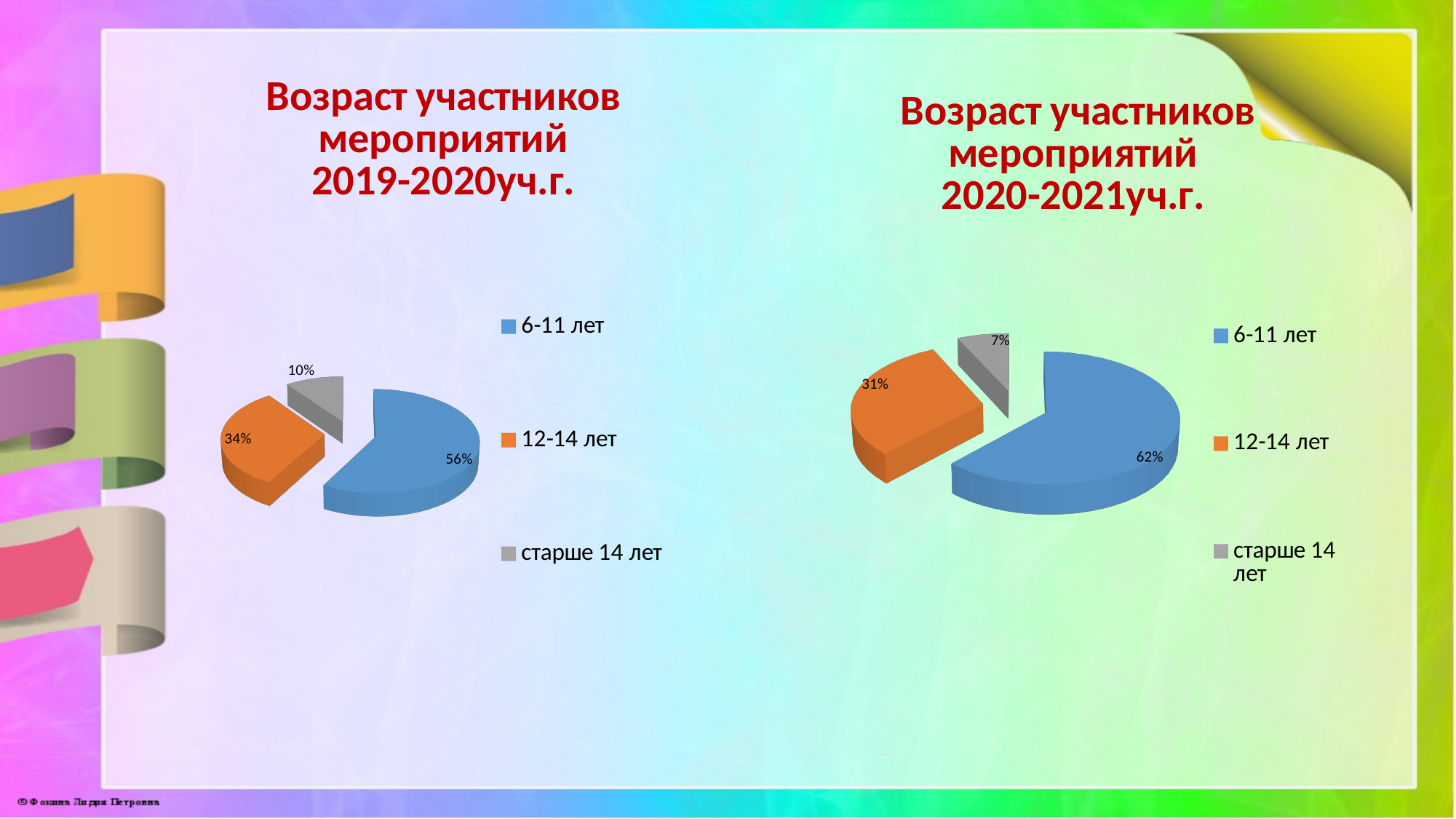
How many categories does the legend of the chart titled 'Возраст участников мероприятий 2019-2020уч.г.' list? 3 In the chart titled 'Возраст участников мероприятий 2019-2020уч.г.', what is the difference between the shares for 6-11 лет and 12-14 лет? 22% What type of chart is the one titled 'Возраст участников мероприятий 2020-2021уч.г.'? Pie chart In the chart titled 'Возраст участников мероприятий 2020-2021уч.г.', which is larger: the share for 12-14 лет or the share for старше 14 лет? 12-14 лет In the chart titled 'Возраст участников мероприятий 2020-2021уч.г.', what share is shown for старше 14 лет? 7% In the chart titled 'Возраст участников мероприятий 2019-2020уч.г.', what share is shown for старше 14 лет? 10% In the chart titled 'Возраст участников мероприятий 2019-2020уч.г.', what share is shown for 12-14 лет? 34% In the chart titled 'Возраст участников мероприятий 2020-2021уч.г.', which age group has the smallest share? старше 14 лет In the chart titled 'Возраст участников мероприятий 2020-2021уч.г.', what share is shown for 6-11 лет? 62% In the chart titled 'Возраст участников мероприятий 2019-2020уч.г.', which age group has the largest share? 6-11 лет In the chart titled 'Возраст участников мероприятий 2020-2021уч.г.', what share is shown for 12-14 лет? 31% In the chart titled 'Возраст участников мероприятий 2019-2020уч.г.', what share is shown for 6-11 лет? 56%